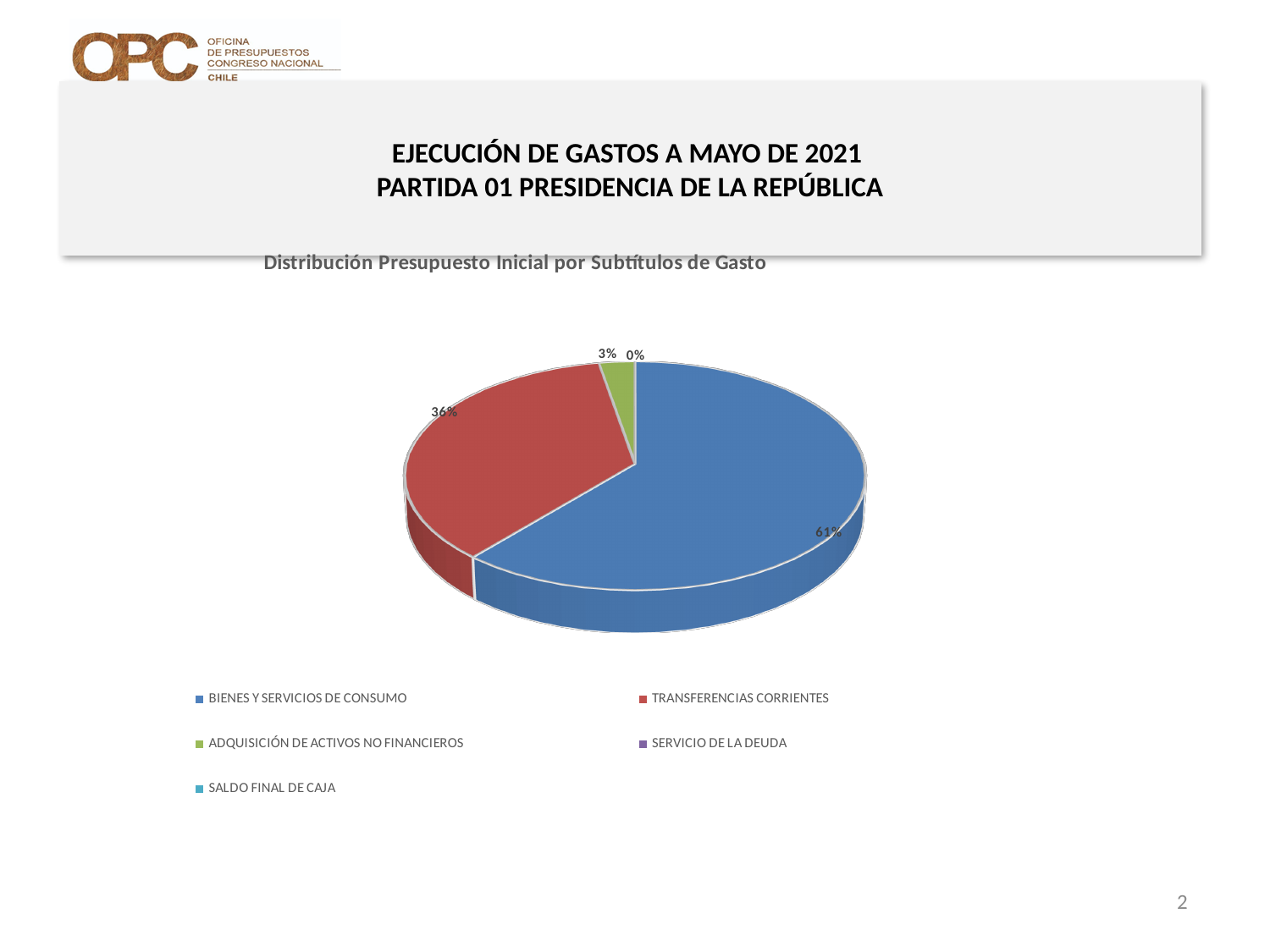
Which category has the largest slice of the pie? BIENES Y SERVICIOS DE CONSUMO What colour is the slice for BIENES Y SERVICIOS DE CONSUMO? Blue What kind of chart is shown on the slide? Pie chart What is the title of the pie chart? Distribución Presupuesto Inicial por Subtítulos de Gasto What is the combined share of BIENES Y SERVICIOS DE CONSUMO and TRANSFERENCIAS CORRIENTES? 97% By how many percentage points does BIENES Y SERVICIOS DE CONSUMO exceed TRANSFERENCIAS CORRIENTES? 25 percentage points How many entries does the legend list? 5 What share of the pie does BIENES Y SERVICIOS DE CONSUMO represent? 61% What share of the pie does TRANSFERENCIAS CORRIENTES represent? 36% What share of the pie does SERVICIO DE LA DEUDA represent? 0% Which is larger, the slice for TRANSFERENCIAS CORRIENTES or the slice for ADQUISICIÓN DE ACTIVOS NO FINANCIEROS? TRANSFERENCIAS CORRIENTES